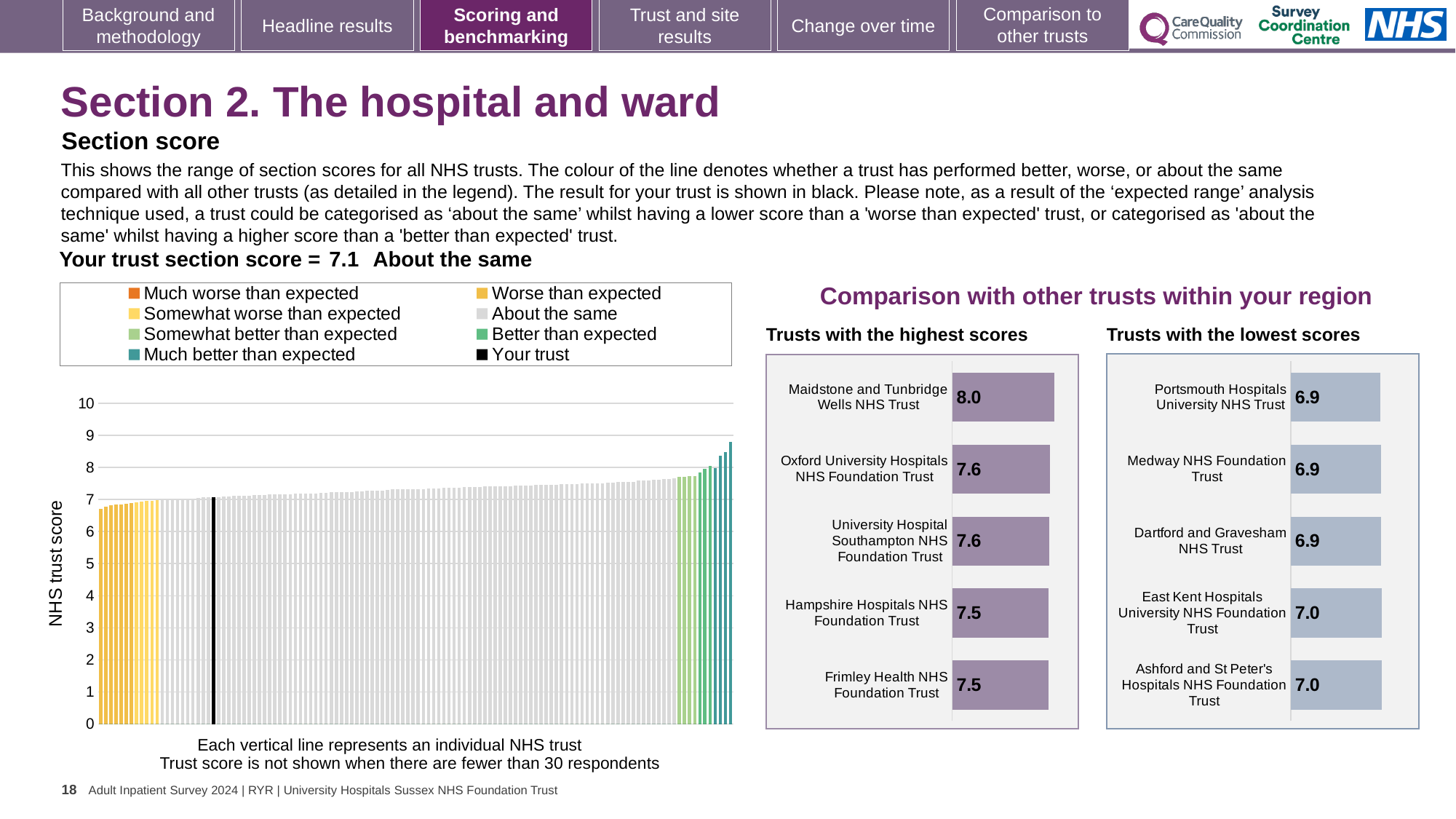
In the 'Trusts with the lowest scores' chart, what is the score for Medway NHS Foundation Trust? 6.9 What kind of chart is the 'Trusts with the highest scores' chart? Bar chart How many entries does the legend of the main 'NHS trust score' chart on the left list? 8 In the 'Trusts with the highest scores' chart, how many trusts are shown? 5 In the 'Trusts with the lowest scores' chart, what is the score for East Kent Hospitals University NHS Foundation Trust? 7.0 In the 'Trusts with the highest scores' chart, what is the difference between the scores of Maidstone and Tunbridge Wells NHS Trust and Frimley Health NHS Foundation Trust? 0.5 In the 'Trusts with the highest scores' chart, what is the score for Maidstone and Tunbridge Wells NHS Trust? 8.0 In the 'Trusts with the lowest scores' chart, what is the difference between the scores of Ashford and St Peter's Hospitals NHS Foundation Trust and Dartford and Gravesham NHS Trust? 0.1 In the main 'NHS trust score' chart on the left, do the bar values rise or fall from left to right? Rise In the 'Trusts with the lowest scores' chart, which is larger: the score for Portsmouth Hospitals University NHS Trust or the score for Ashford and St Peter's Hospitals NHS Foundation Trust? Ashford and St Peter's Hospitals NHS Foundation Trust In the main 'NHS trust score' chart on the left, what is the section score for your trust (the black bar)? 7.1 In the 'Trusts with the highest scores' chart, which trust has the highest score? Maidstone and Tunbridge Wells NHS Trust